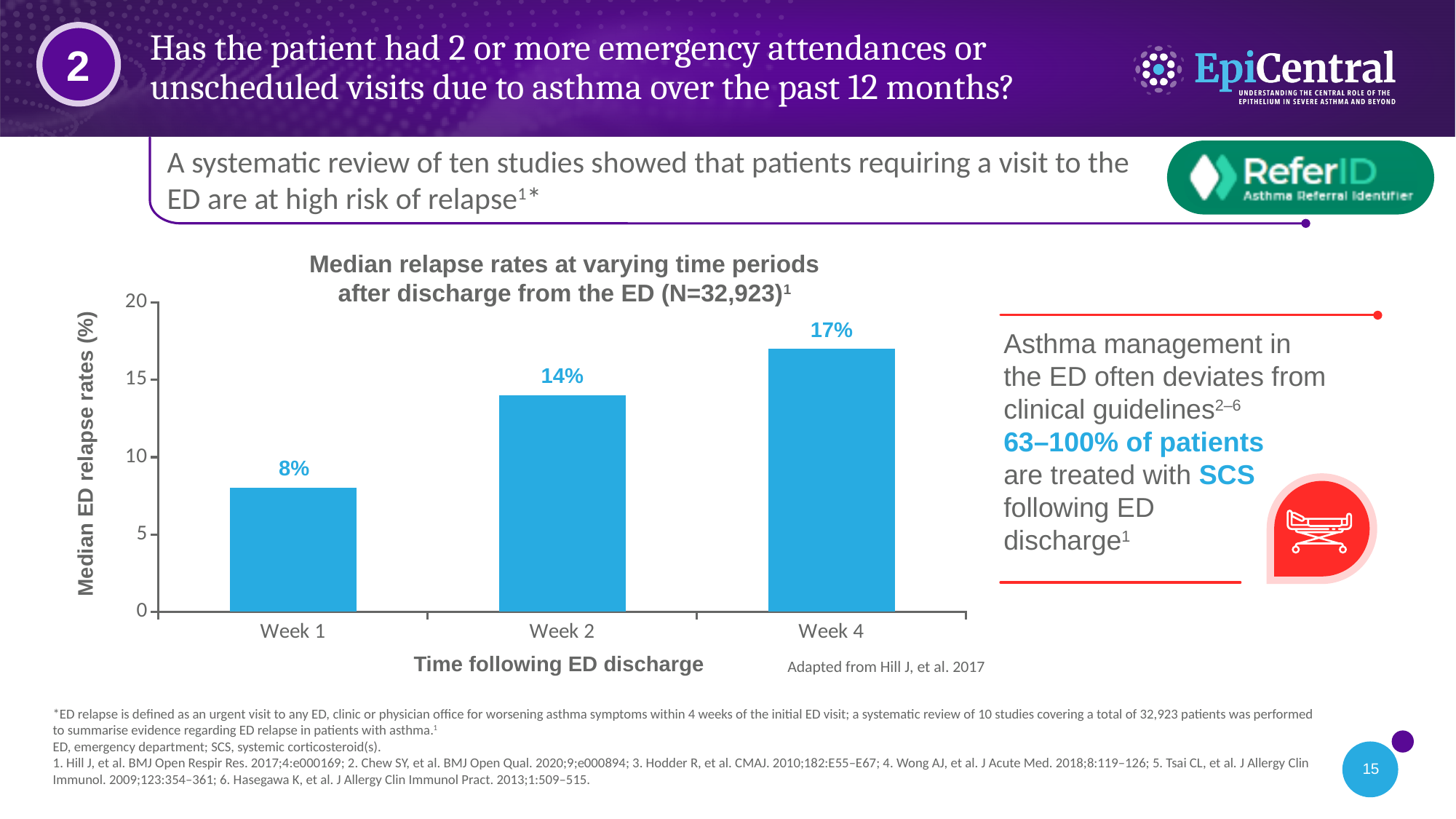
What is the difference between the median relapse rates at Week 4 and Week 1? 9% What is the median ED relapse rate at Week 2? 14% Is the median relapse rate at Week 2 greater or less than 10? greater What is the median ED relapse rate at Week 1? 8% What is the difference between the median relapse rates at Week 2 and Week 1? 6% Which time period has the lowest median ED relapse rate? Week 1 Which time period has the highest median ED relapse rate? Week 4 Do the median relapse rates rise or fall as time following ED discharge increases? Rise What is the median ED relapse rate at Week 4? 17% Which has a higher median relapse rate, Week 2 or Week 4? Week 4 What kind of chart is used to show the median relapse rates? Bar chart How many time periods are shown on the x axis of the chart? 3